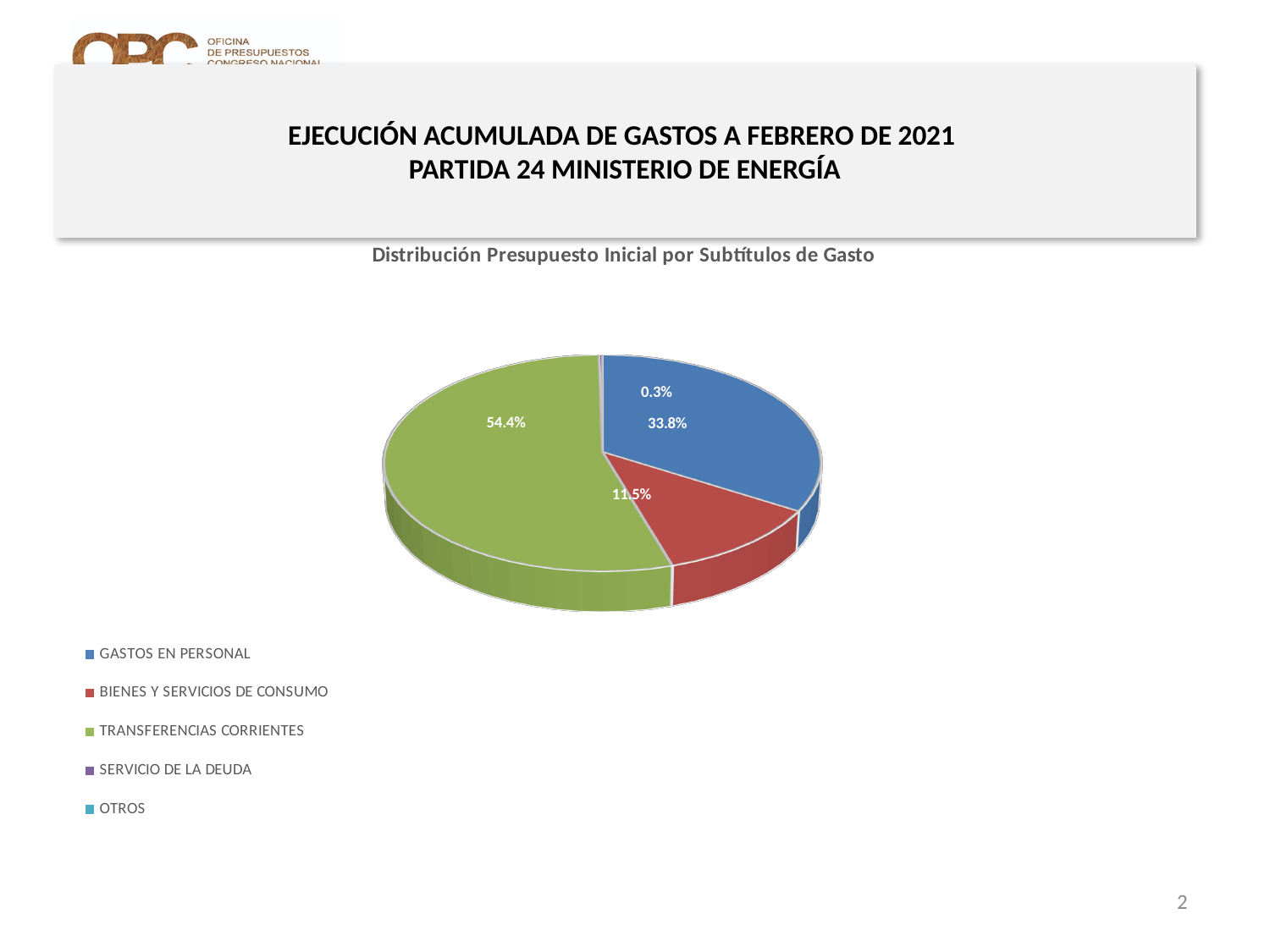
What colour is used for TRANSFERENCIAS CORRIENTES in the pie chart? Green What kind of chart is shown on the slide? Pie chart How many categories are listed in the chart's legend? 5 What share of the pie does GASTOS EN PERSONAL represent? 33.8% By how many percentage points does TRANSFERENCIAS CORRIENTES exceed GASTOS EN PERSONAL? 20.6 percentage points Which category has the largest slice of the pie? TRANSFERENCIAS CORRIENTES By how many percentage points does GASTOS EN PERSONAL exceed BIENES Y SERVICIOS DE CONSUMO? 22.3 percentage points What is the smallest percentage label shown on the pie? 0.3% What share of the pie does TRANSFERENCIAS CORRIENTES represent? 54.4% Which is larger, the slice for GASTOS EN PERSONAL or the slice for BIENES Y SERVICIOS DE CONSUMO? GASTOS EN PERSONAL What is the title of the pie chart? Distribución Presupuesto Inicial por Subtítulos de Gasto What share of the pie does BIENES Y SERVICIOS DE CONSUMO represent? 11.5%